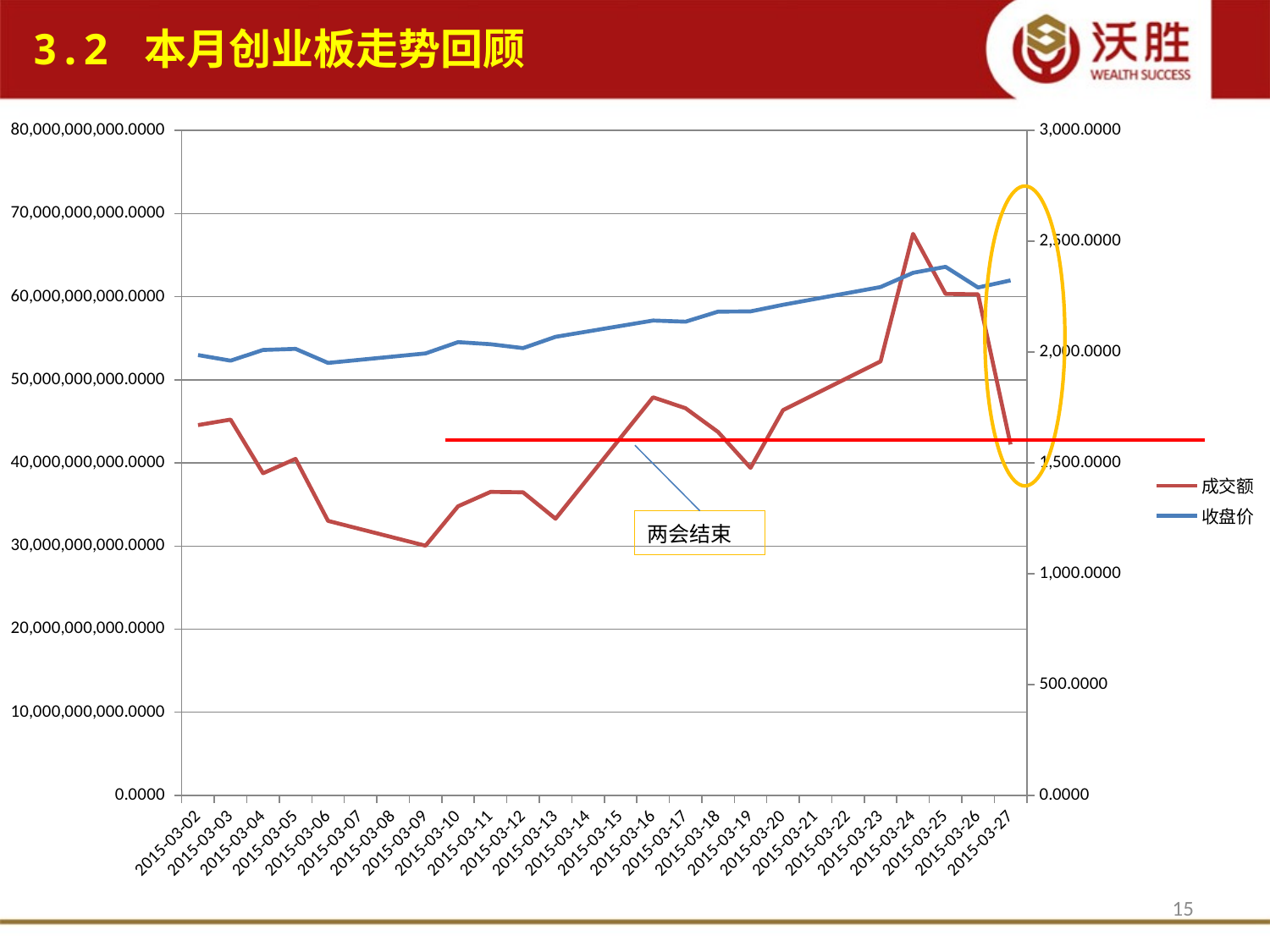
Is the value of 成交额 on 2015-03-24 greater or less than 60,000,000,000.0000? greater Is the value of 成交额 on 2015-03-09 greater or less than 40,000,000,000.0000? less How many series does the legend list? 2 On which date does 成交额 reach its lowest value? 2015-03-09 Which is larger, 成交额 on 2015-03-16 or 成交额 on 2015-03-19? 2015-03-16 On which date does 收盘价 reach its highest value? 2015-03-25 What are the two series named in the legend? 成交额 and 收盘价 Does 收盘价 generally rise or fall from 2015-03-02 to 2015-03-27? rise On which date does 成交额 reach its highest value? 2015-03-24 What kind of chart is shown on the slide? line chart How many dates are plotted along the x axis? 26 Is the value of 收盘价 on 2015-03-25 greater or less than 2,000.0000? greater